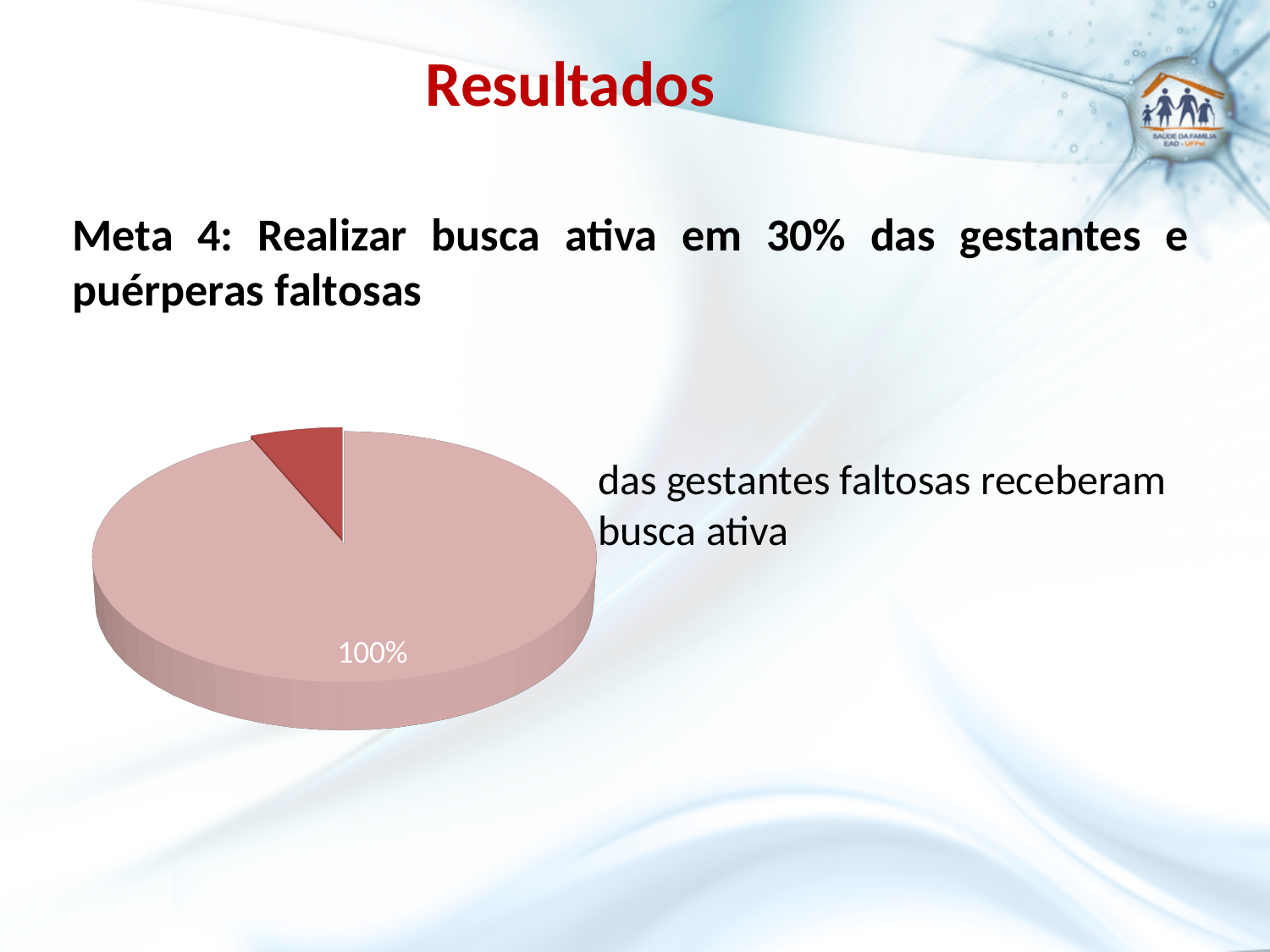
What is the title of the slide containing the pie chart? Resultados Which slice of the pie chart is larger, the light pink one or the dark red one? the light pink one How many slices of the pie chart have a printed data label? 1 What kind of chart is shown on the slide? pie chart Which slice of the pie chart is the smallest? the dark red slice Does the pie chart have a legend? No What value is printed on the large light pink slice of the pie chart? 100% How many slices does the pie chart have? 2